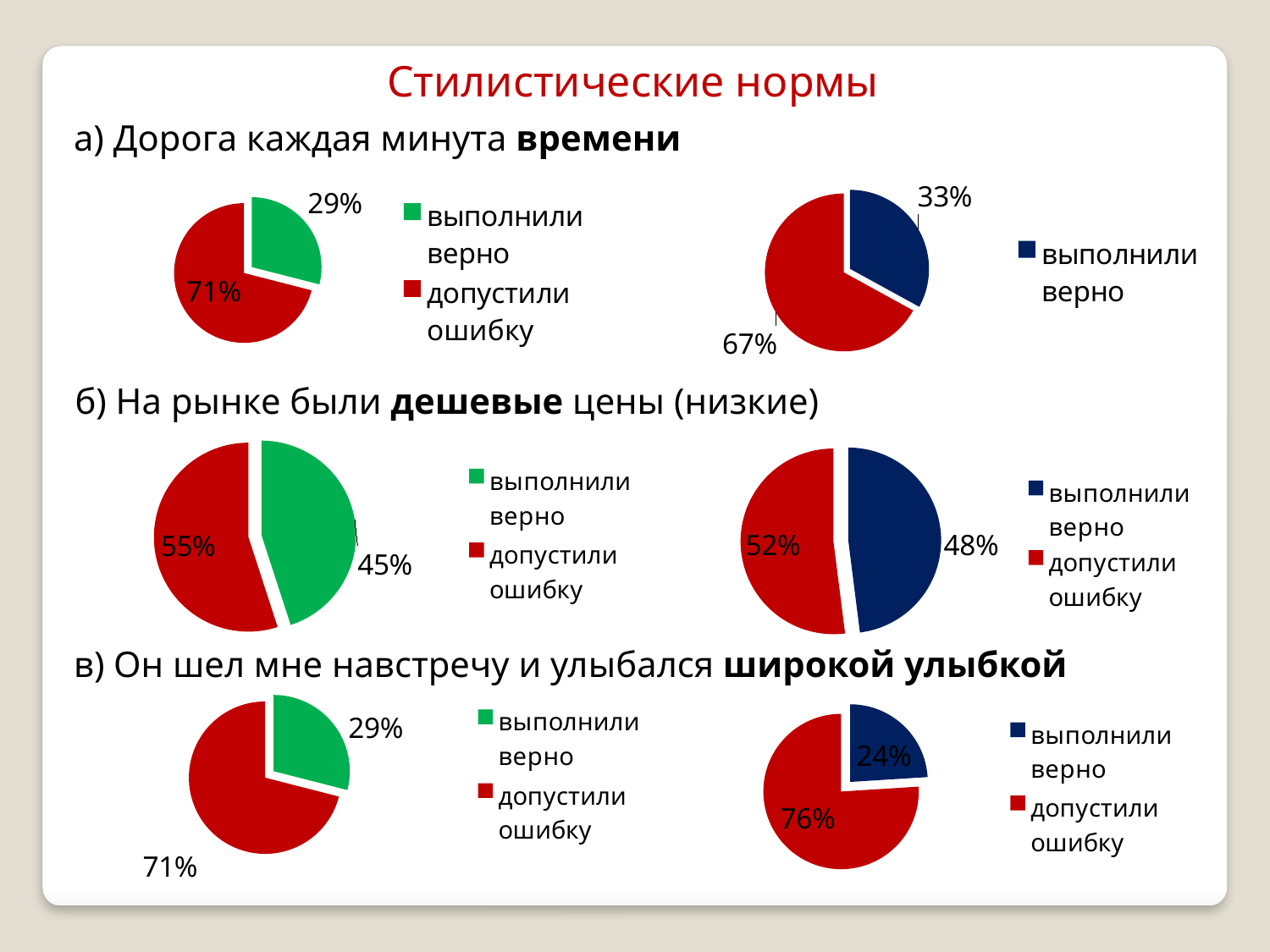
In the right pie chart under sentence в) ("Он шел мне навстречу и улыбался широкой улыбкой"), what share is labelled for "выполнили верно"? 24% In the right pie chart under sentence в), what share is labelled for "допустили ошибку"? 76% In the right pie chart under sentence б), which slice is larger: "выполнили верно" or "допустили ошибку"? допустили ошибку In the right pie chart under sentence a), what percentage is shown for the red slice? 67% In the left pie chart under sentence в), what is the difference between the "допустили ошибку" share and the "выполнили верно" share? 42% In the right pie chart under sentence б), what is the difference between the "допустили ошибку" share and the "выполнили верно" share? 4% In the left pie chart under sentence a), what share is labelled for "допустили ошибку"? 71% What type of chart is used throughout this slide? Pie chart In the left pie chart under sentence a) ("Дорога каждая минута времени"), what share is labelled for "выполнили верно"? 29% In the right pie chart under sentence a), what percentage is shown for the blue slice ("выполнили верно")? 33% How many entries does the legend of the right pie chart under sentence a) list? 1 In the left pie chart under sentence б) ("На рынке были дешевые цены"), what share is labelled for "выполнили верно"? 45%